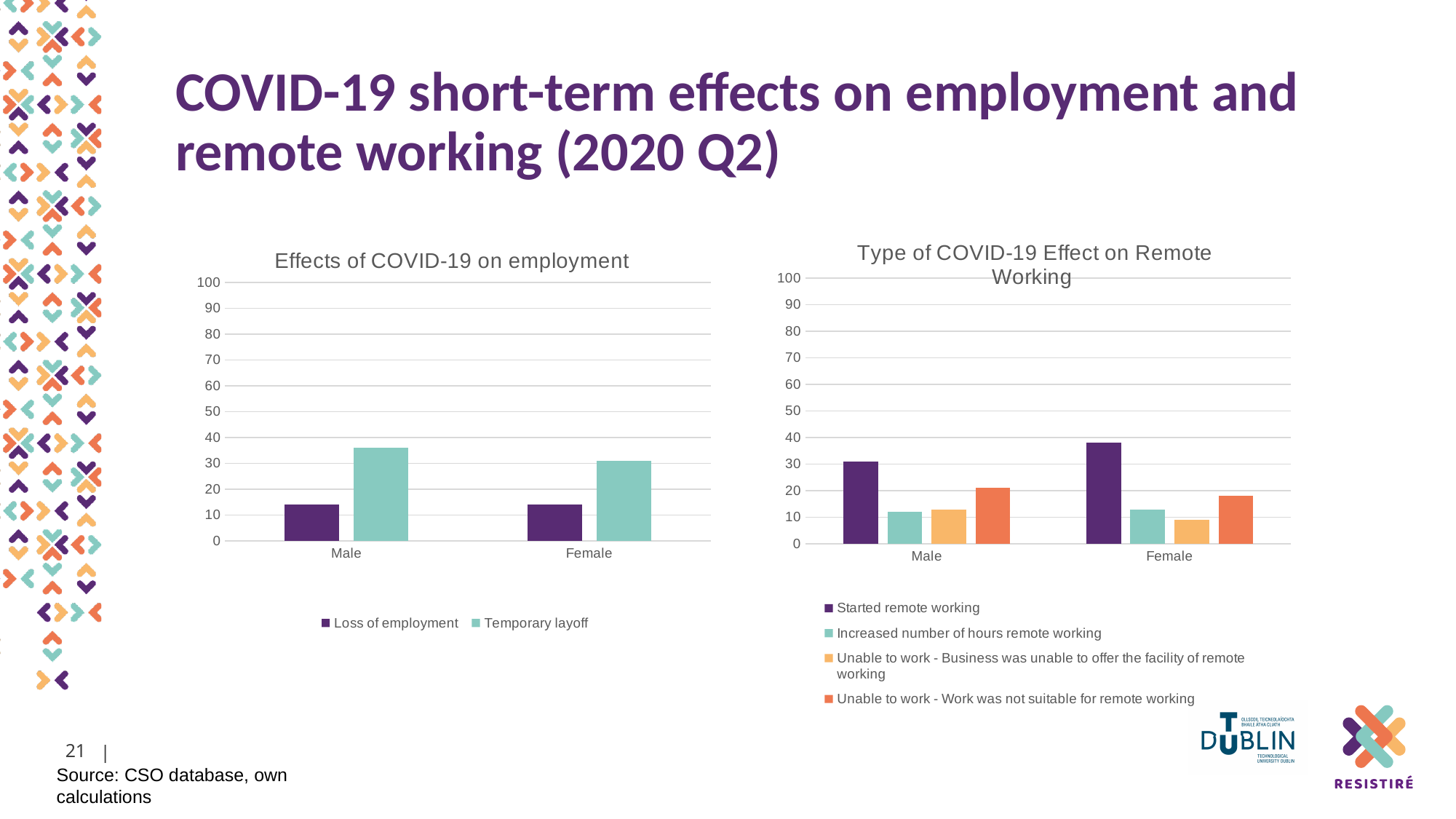
In the 'Effects of COVID-19 on employment' chart, is the Temporary layoff value for Male greater or less than 30? greater In the 'Effects of COVID-19 on employment' chart, how many categories are shown on the x axis? 2 In the 'Type of COVID-19 Effect on Remote Working' chart, which has the larger 'Started remote working' value, Male or Female? Female In the 'Effects of COVID-19 on employment' chart, how many series does the legend list? 2 In the 'Type of COVID-19 Effect on Remote Working' chart, which series has the lowest value for Female? Unable to work - Business was unable to offer the facility of remote working What type of chart is the 'Effects of COVID-19 on employment' chart? bar chart In the 'Type of COVID-19 Effect on Remote Working' chart, is the 'Increased number of hours remote working' value for Male greater or less than 20? less In the 'Type of COVID-19 Effect on Remote Working' chart, how many series does the legend list? 4 In the 'Effects of COVID-19 on employment' chart, is the Loss of employment value for Male greater or less than 20? less In the 'Type of COVID-19 Effect on Remote Working' chart, which series has the highest value for Female? Started remote working In the 'Effects of COVID-19 on employment' chart, which has the larger Temporary layoff value, Male or Female? Male